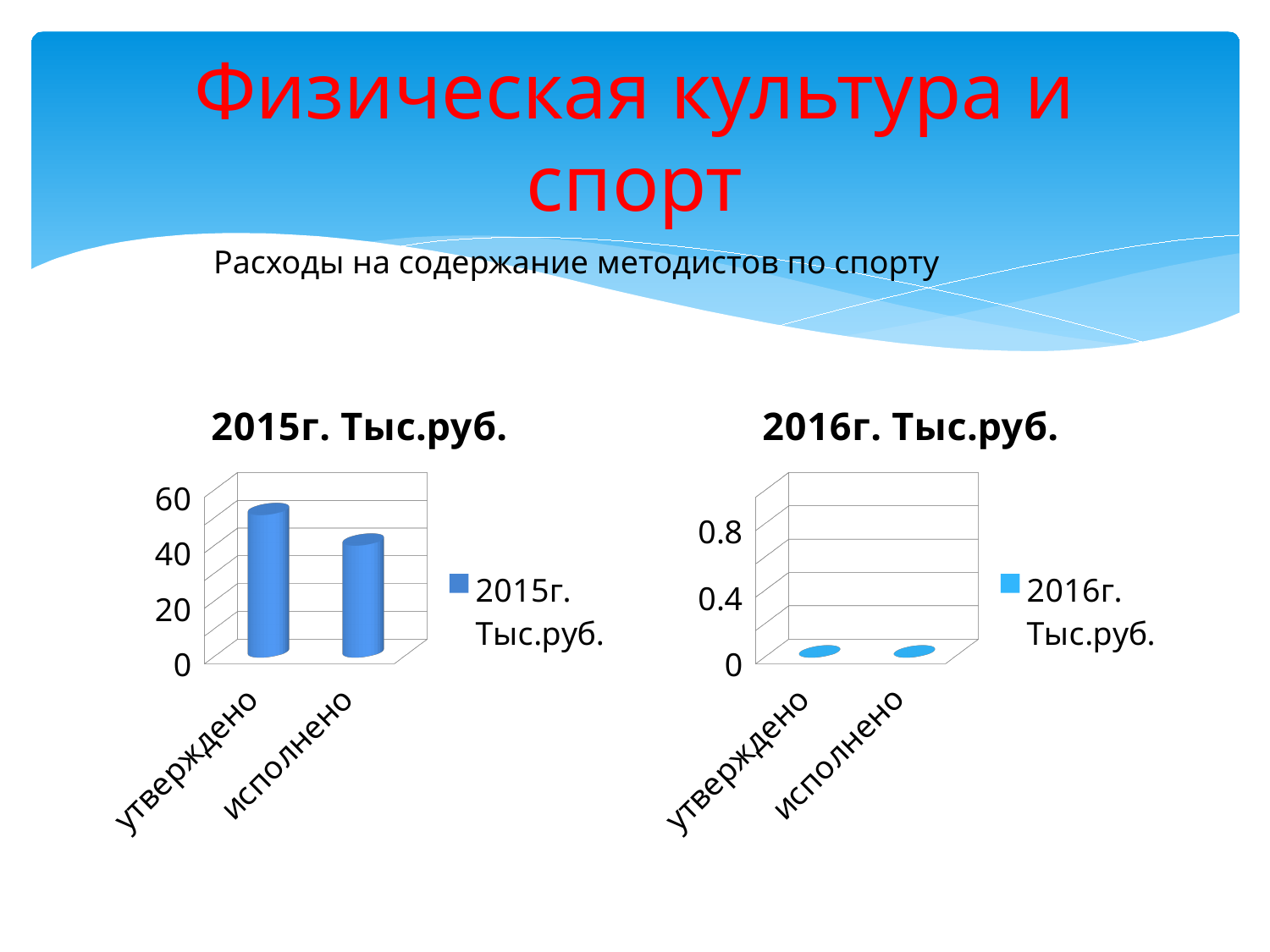
In the "2015г. Тыс.руб." chart, is the value for утверждено greater or less than 60? less What kind of chart is the "2015г. Тыс.руб." chart? bar chart In the "2015г. Тыс.руб." chart, is the value for исполнено greater or less than 20? greater What is the title of the chart on the right side of the slide? 2016г. Тыс.руб. What is the legend entry of the "2015г. Тыс.руб." chart? 2015г. Тыс.руб. In the "2015г. Тыс.руб." chart, which category has the highest value? утверждено In the "2015г. Тыс.руб." chart, which category has the lowest value? исполнено In the "2015г. Тыс.руб." chart, which is larger: утверждено or исполнено? утверждено In the "2016г. Тыс.руб." chart, is the value for утверждено greater or less than 0.4? less How many series does the legend of the "2016г. Тыс.руб." chart list? 1 How many categories are shown on the x axis of the "2015г. Тыс.руб." chart? 2